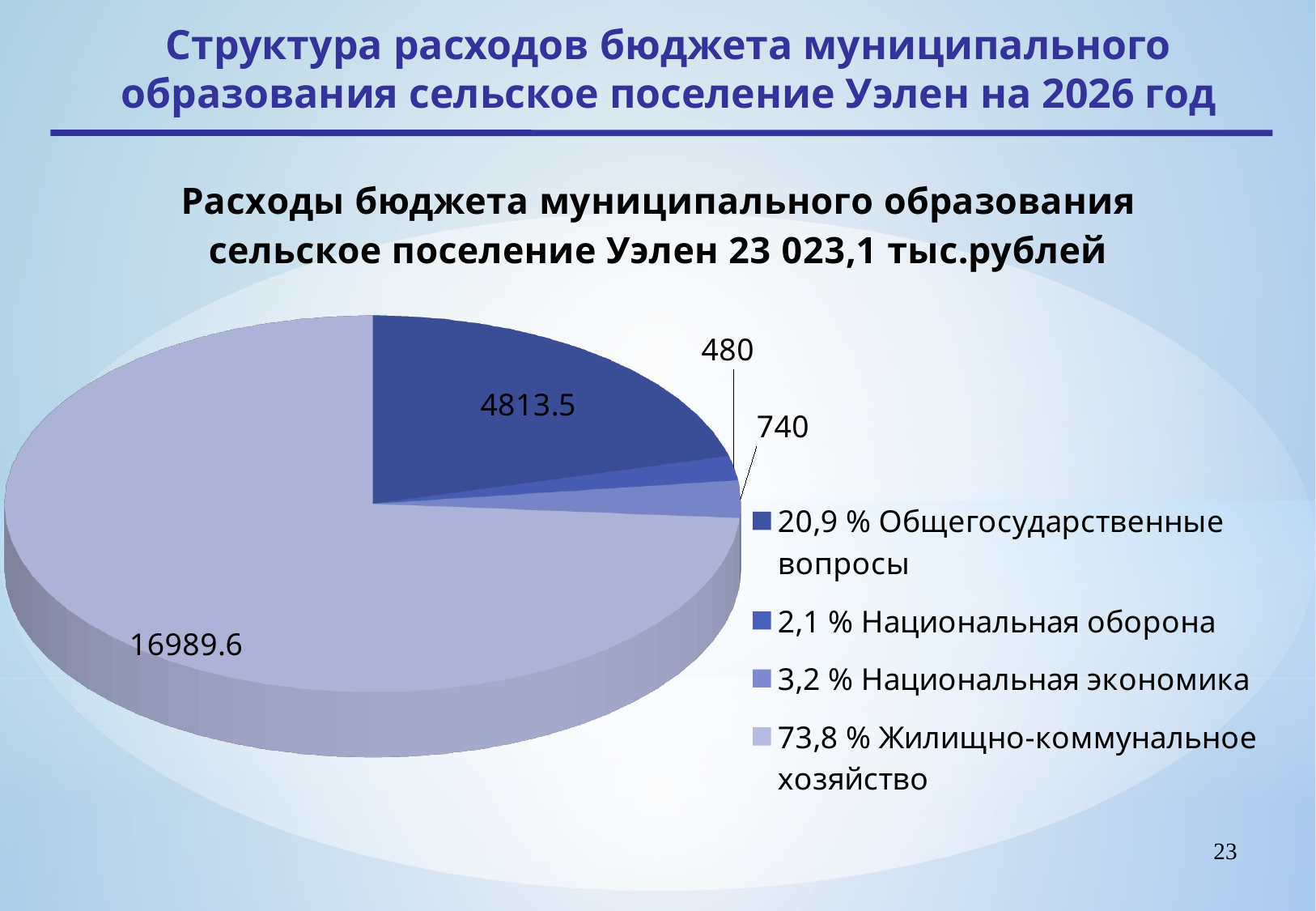
What kind of chart is shown on the slide? Pie chart What is the value for Национальная экономика? 740 What share of the pie does Общегосударственные вопросы represent? 20,9 % Which is larger, the value for Национальная экономика or the value for Национальная оборона? Национальная экономика What is the value for Национальная оборона? 480 What is the difference between the values for Жилищно-коммунальное хозяйство and Общегосударственные вопросы? 12176.1 What is the difference between the values for Национальная экономика and Национальная оборона? 260 Which category has the smallest slice of the pie? Национальная оборона What is the value for Общегосударственные вопросы? 4813.5 What is the value for Жилищно-коммунальное хозяйство? 16989.6 How many slices does the pie chart have? 4 Which category has the largest slice of the pie? Жилищно-коммунальное хозяйство